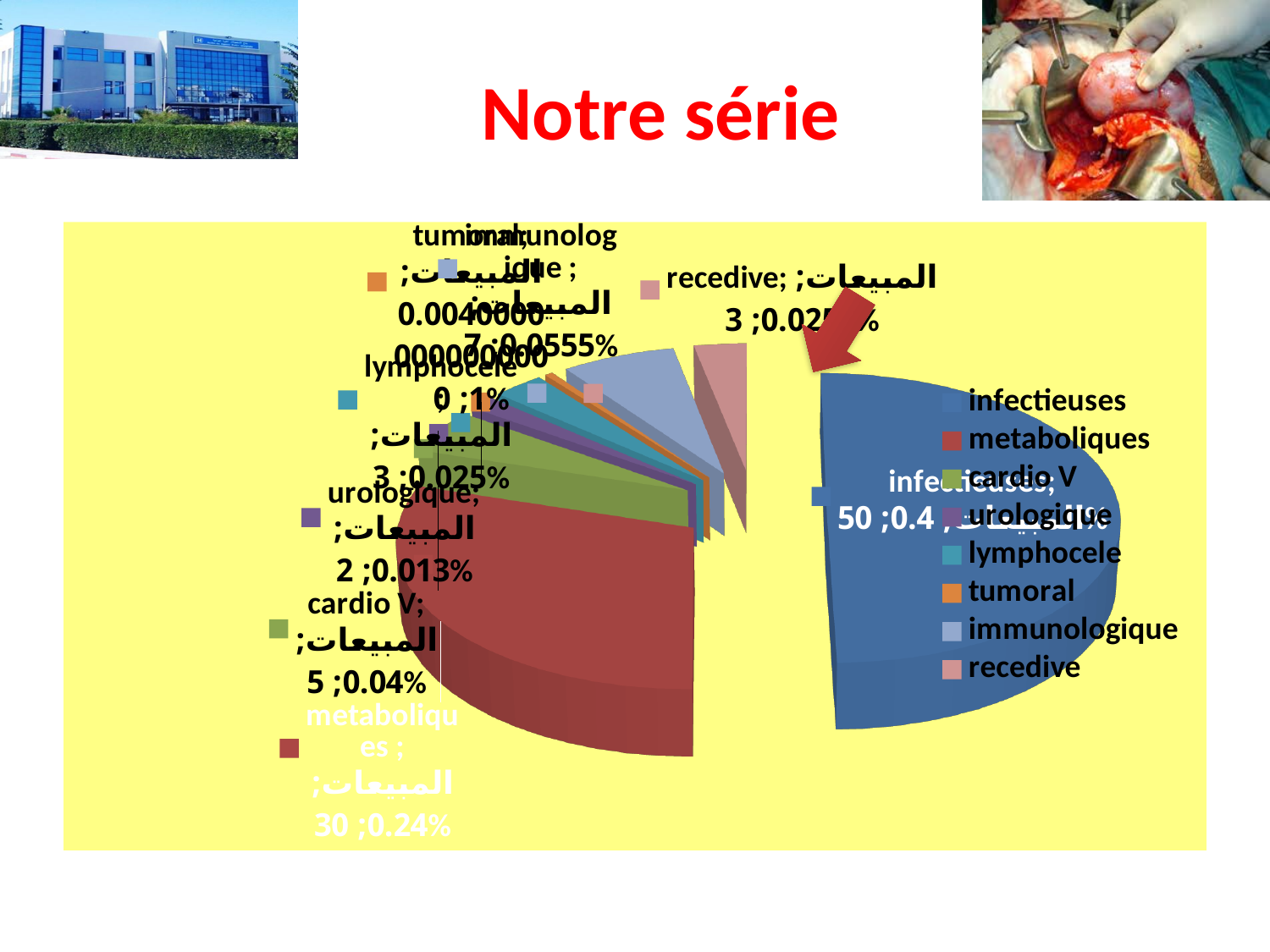
What is the value shown for cardio V in the pie chart? 5 What is the value shown for urologique in the pie chart? 2 Which is larger in the pie chart, metaboliques or cardio V? metaboliques What kind of chart is shown on the slide? pie chart What is the value shown for metaboliques in the pie chart? 30 What is the difference between the values for infectieuses and metaboliques in the pie chart? 20 What is the title of the slide containing the pie chart? Notre série Which category has the largest slice in the pie chart? infectieuses What is the value shown for immunologique in the pie chart? 7 What is the value shown for recedive in the pie chart? 3 How many categories does the legend of the pie chart list? 8 What is the value shown for infectieuses in the pie chart? 50